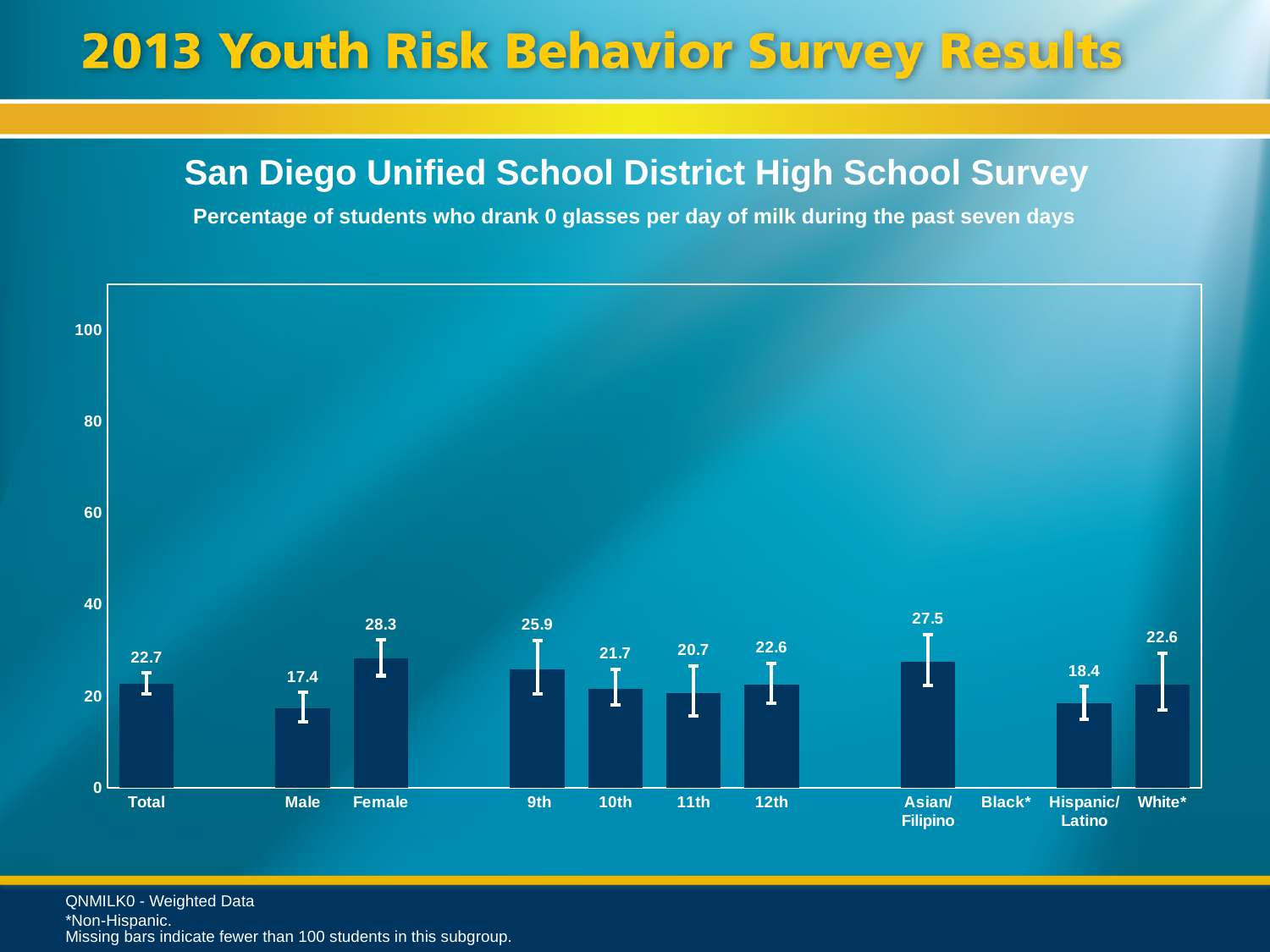
What is the value for Female? 28.3 What is the value for 11th graders? 20.7 Which category label has no bar plotted? Black* Which category has the highest value? Female Which is larger, the value for 9th graders or the value for 12th graders? 9th Is the value for Total greater or less than 40? less What is the difference between the Female and Male values? 10.9 What kind of chart is shown? Bar chart How many bars are plotted on the chart? 11 What is the value for Asian/Filipino? 27.5 What is the value for Hispanic/Latino? 18.4 Which category has the lowest value among the plotted bars? Male